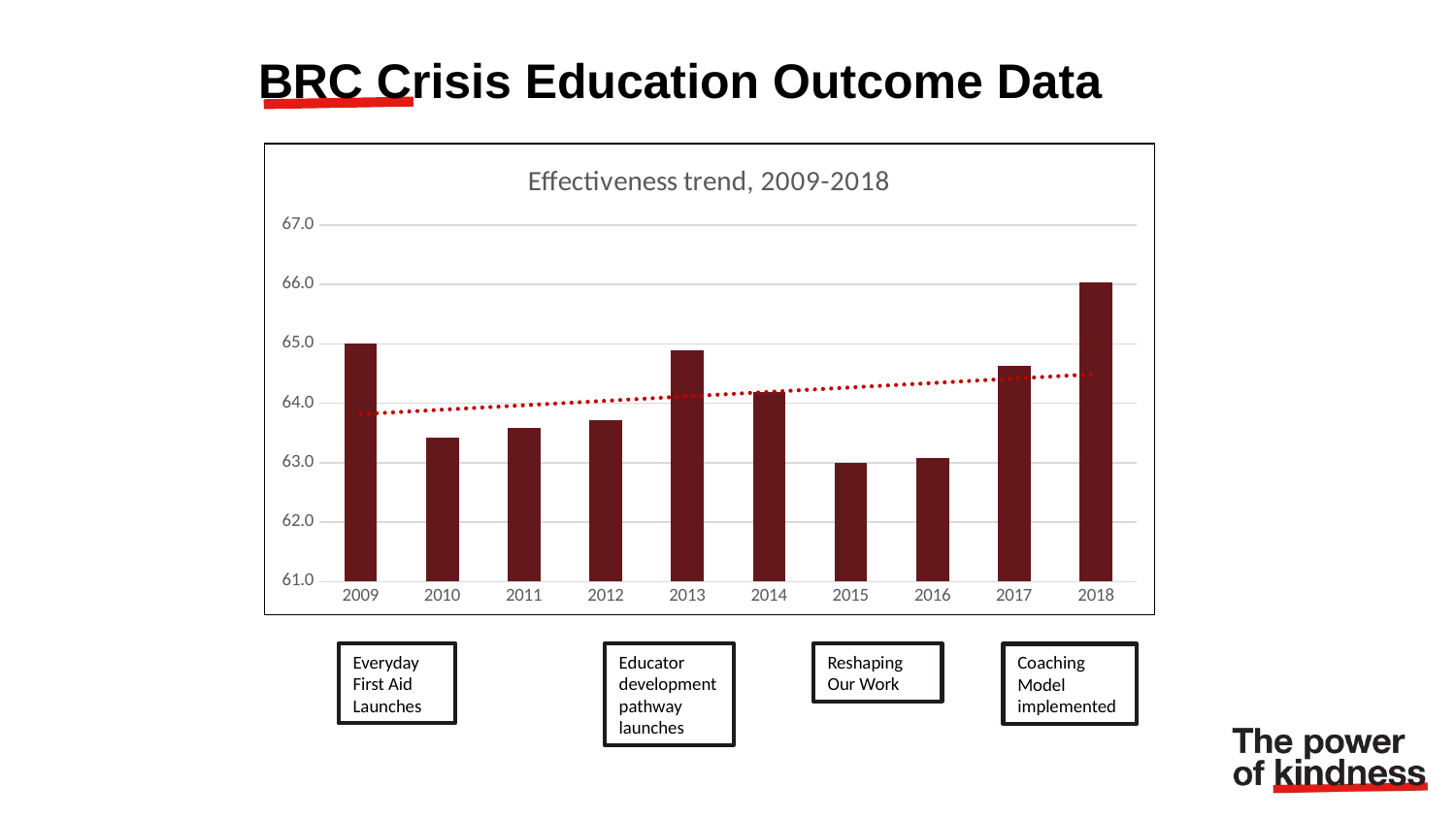
Does the dotted trend line in the chart rise or fall from 2009 to 2018? Rise Is the value for 2013 greater or less than 64.0? greater Is the value for 2017 greater or less than 64.0? greater Is the value for 2010 greater or less than 64.0? less What is the title of the chart? Effectiveness trend, 2009-2018 How many years are plotted on the x axis of the chart? 10 Which year has the larger value, 2013 or 2014? 2013 Which year has the larger value, 2017 or 2016? 2017 Which year has the highest bar in the chart? 2018 What kind of chart is shown on the slide? Bar chart